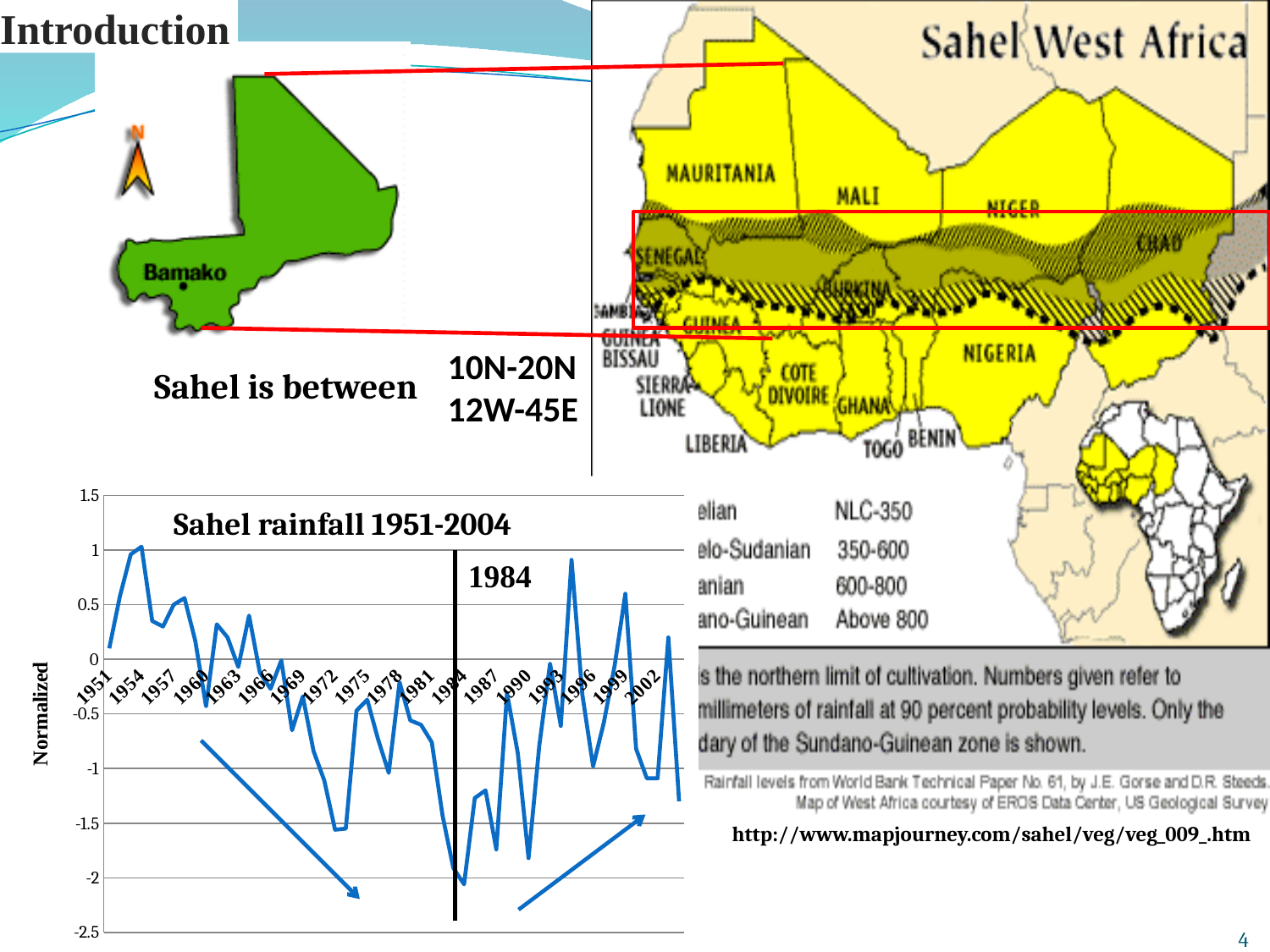
What kind of chart is the Sahel rainfall chart? line chart How many year labels are shown on the x axis of the Sahel rainfall chart? 18 In the Sahel rainfall chart, which year has the highest normalized rainfall value? 1954 In the Sahel rainfall chart, do the values generally rise or fall from 1954 to 1984? fall What is the label on the vertical axis of the Sahel rainfall chart? Normalized In the Sahel rainfall chart, which year has the larger value, 1954 or 1984? 1954 In the Sahel rainfall chart, which year has the lowest normalized rainfall value? 1984 What is the title of the chart on the slide? Sahel rainfall 1951-2004 In the Sahel rainfall chart, is the value for 1972 greater or less than -1? less In the Sahel rainfall chart, is the value for 1984 greater or less than -1.5? less In the Sahel rainfall chart, is the value for 1954 greater or less than 0.5? greater